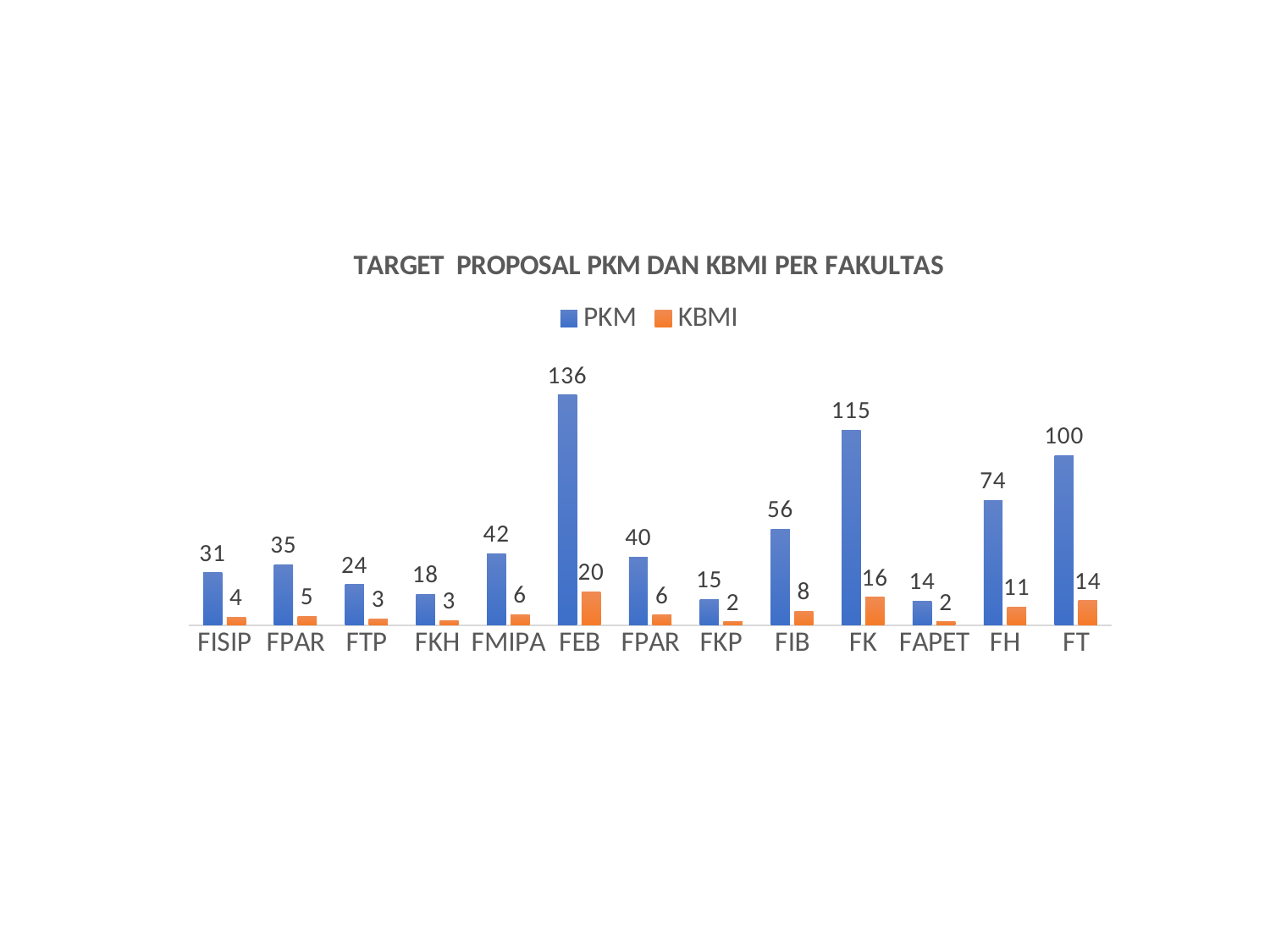
What is the PKM value for FH? 74 What is the title of the chart? TARGET PROPOSAL PKM DAN KBMI PER FAKULTAS How many series does the legend list? 2 Which faculty has the highest PKM value? FEB What is the KBMI value for FK? 16 Which is larger, the PKM value for FT or the PKM value for FH? FT What kind of chart is shown? Bar chart Which faculty has the highest KBMI value? FEB What is the PKM value for FEB? 136 Which faculty has the lowest PKM value? FAPET What is the difference between the PKM values for FEB and FK? 21 How many faculties are shown on the x axis? 13